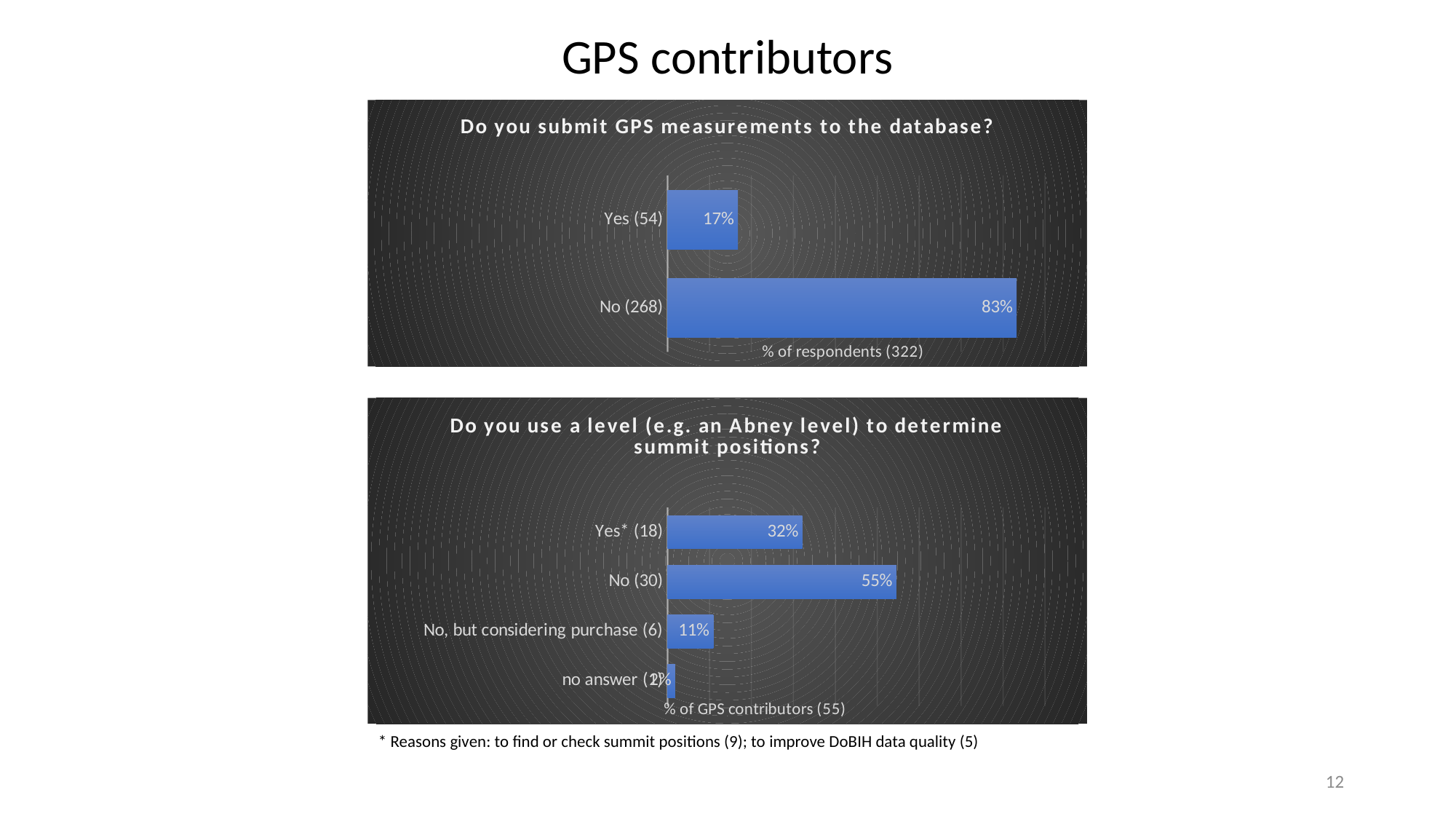
In the top chart, 'Do you submit GPS measurements to the database?', what percentage of respondents answered Yes? 17% In the bottom chart, 'Do you use a level (e.g. an Abney level) to determine summit positions?', what percentage answered 'No, but considering purchase'? 11% In the top chart, 'Do you submit GPS measurements to the database?', how many respondents does the x-axis label say there were? 322 In the bottom chart, 'Do you use a level (e.g. an Abney level) to determine summit positions?', what percentage answered No? 55% In the bottom chart, 'Do you use a level (e.g. an Abney level) to determine summit positions?', which response has the lowest percentage? no answer What type of chart is used for both charts on the slide? Bar chart In the top chart, 'Do you submit GPS measurements to the database?', what is the difference in percentage points between the No and Yes responses? 66 In the bottom chart, 'Do you use a level (e.g. an Abney level) to determine summit positions?', how many response categories are shown? 4 In the bottom chart, 'Do you use a level (e.g. an Abney level) to determine summit positions?', which response has the highest percentage? No (30) In the top chart, 'Do you submit GPS measurements to the database?', how many response categories are shown? 2 In the bottom chart, 'Do you use a level (e.g. an Abney level) to determine summit positions?', what percentage answered Yes? 32% In the top chart, 'Do you submit GPS measurements to the database?', what percentage of respondents answered No? 83%